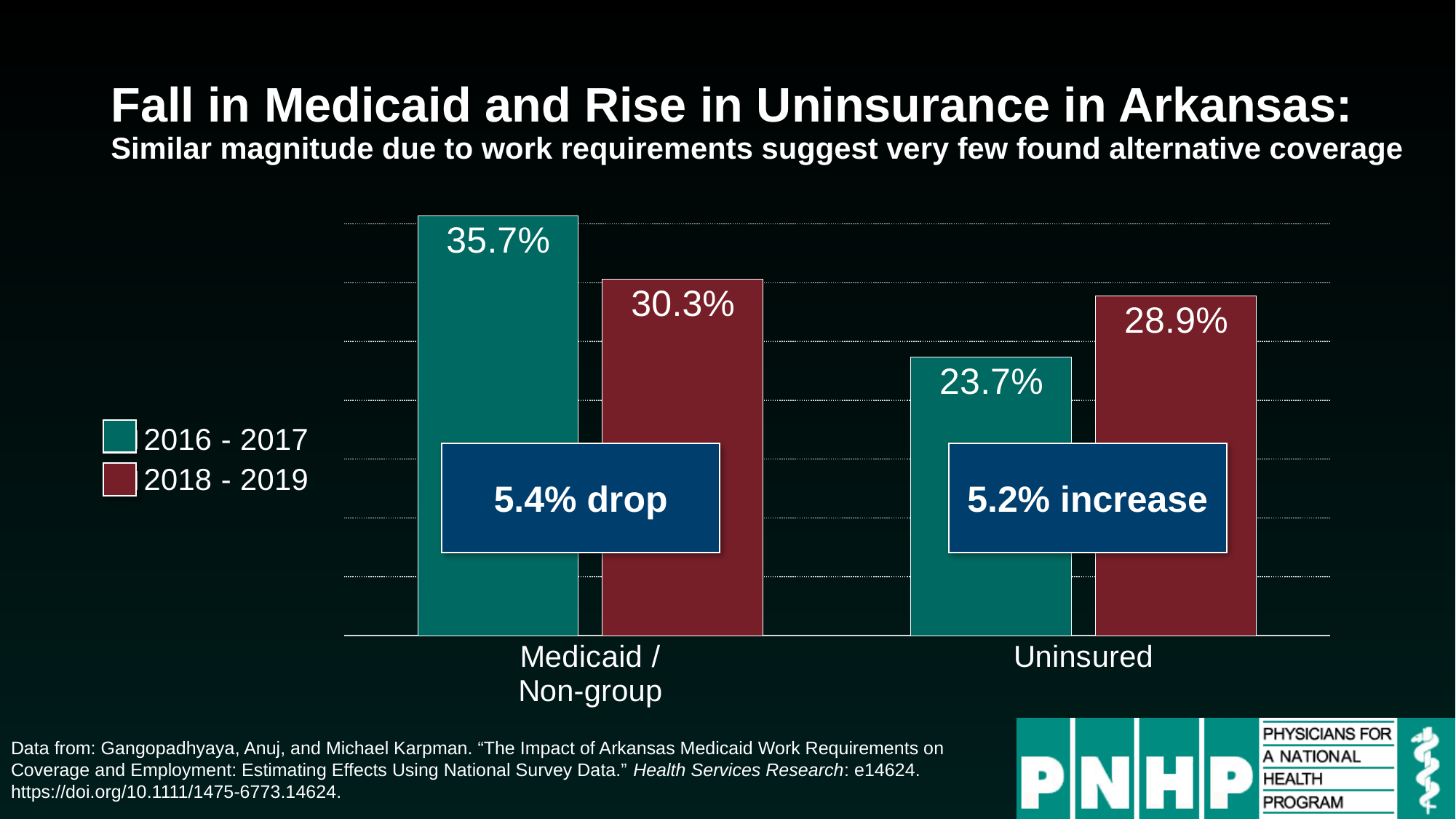
How many series does the legend list? 2 What is the value for Uninsured in 2018 - 2019? 28.9% How many categories are shown on the x axis? 2 What is the value for Medicaid / Non-group in 2018 - 2019? 30.3% What is the difference between the 2018 - 2019 and 2016 - 2017 values for Uninsured? 5.2% Which category has the lowest value in the 2016 - 2017 series? Uninsured What is the difference between the 2016 - 2017 and 2018 - 2019 values for Medicaid / Non-group? 5.4% Which category has the highest value in the 2016 - 2017 series? Medicaid / Non-group Which is larger: the 2018 - 2019 value for Medicaid / Non-group or the 2018 - 2019 value for Uninsured? Medicaid / Non-group What kind of chart is shown on the slide? Bar chart What is the value for Uninsured in 2016 - 2017? 23.7% What is the value for Medicaid / Non-group in 2016 - 2017? 35.7%